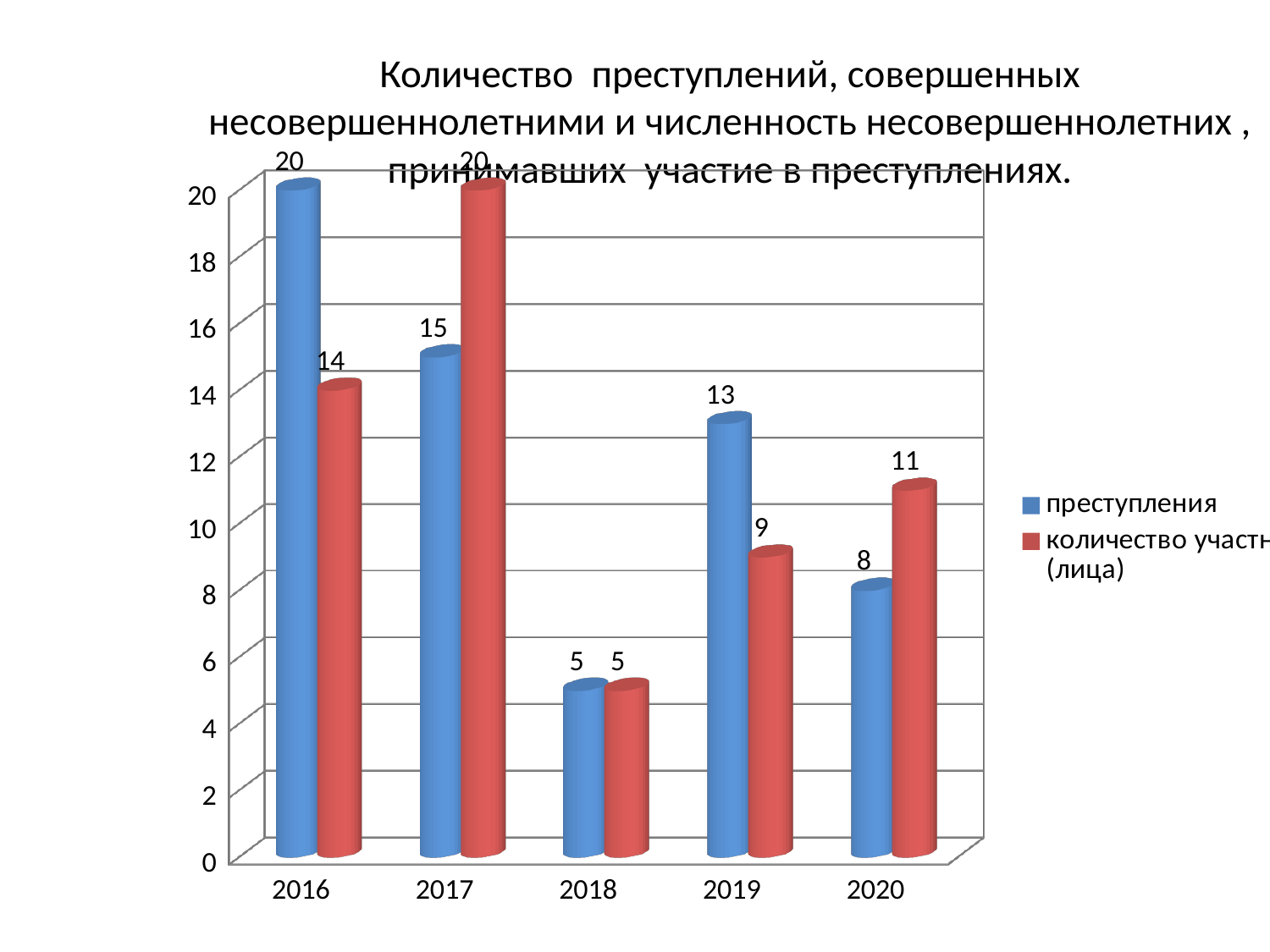
Which colour represents the преступления series? blue In which year is the value for преступления the highest? 2016 What kind of chart is shown on the slide? bar chart How many series does the legend list? 2 What is the value for преступления in 2016? 20 What is the value of the red series in 2020? 11 What is the value for преступления in 2019? 13 What is the difference between the преступления value and the red series value in 2016? 6 Which is larger in 2020: the преступления value or the red series value? the red series value In which year is the value for преступления the lowest? 2018 How many years are shown on the x axis? 5 What is the value of the red series in 2017? 20